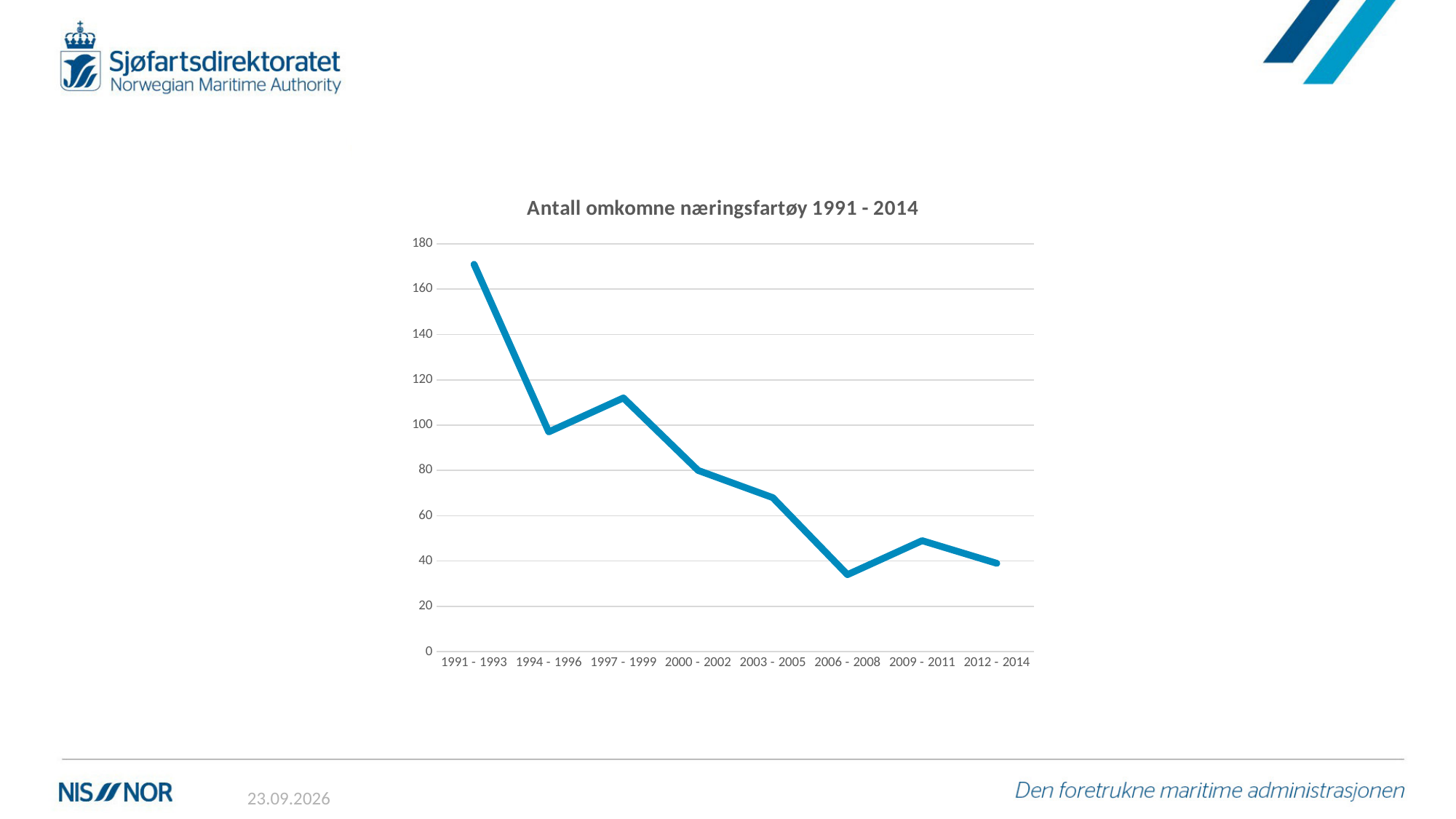
Is the value for 2003 - 2005 greater or less than 60? greater Is the value for 2009 - 2011 greater or less than 60? less What is the title of the chart? Antall omkomne næringsfartøy 1991 - 2014 How many periods are plotted along the x axis? 8 Which period has the highest value? 1991 - 1993 Is the value for 2006 - 2008 greater or less than 40? less Overall, do the values rise or fall from 1991 - 1993 to 2012 - 2014? fall What kind of chart is shown on the slide? line chart Which is larger, the value for 1994 - 1996 or the value for 1997 - 1999? 1997 - 1999 Which period has the lowest value? 2006 - 2008